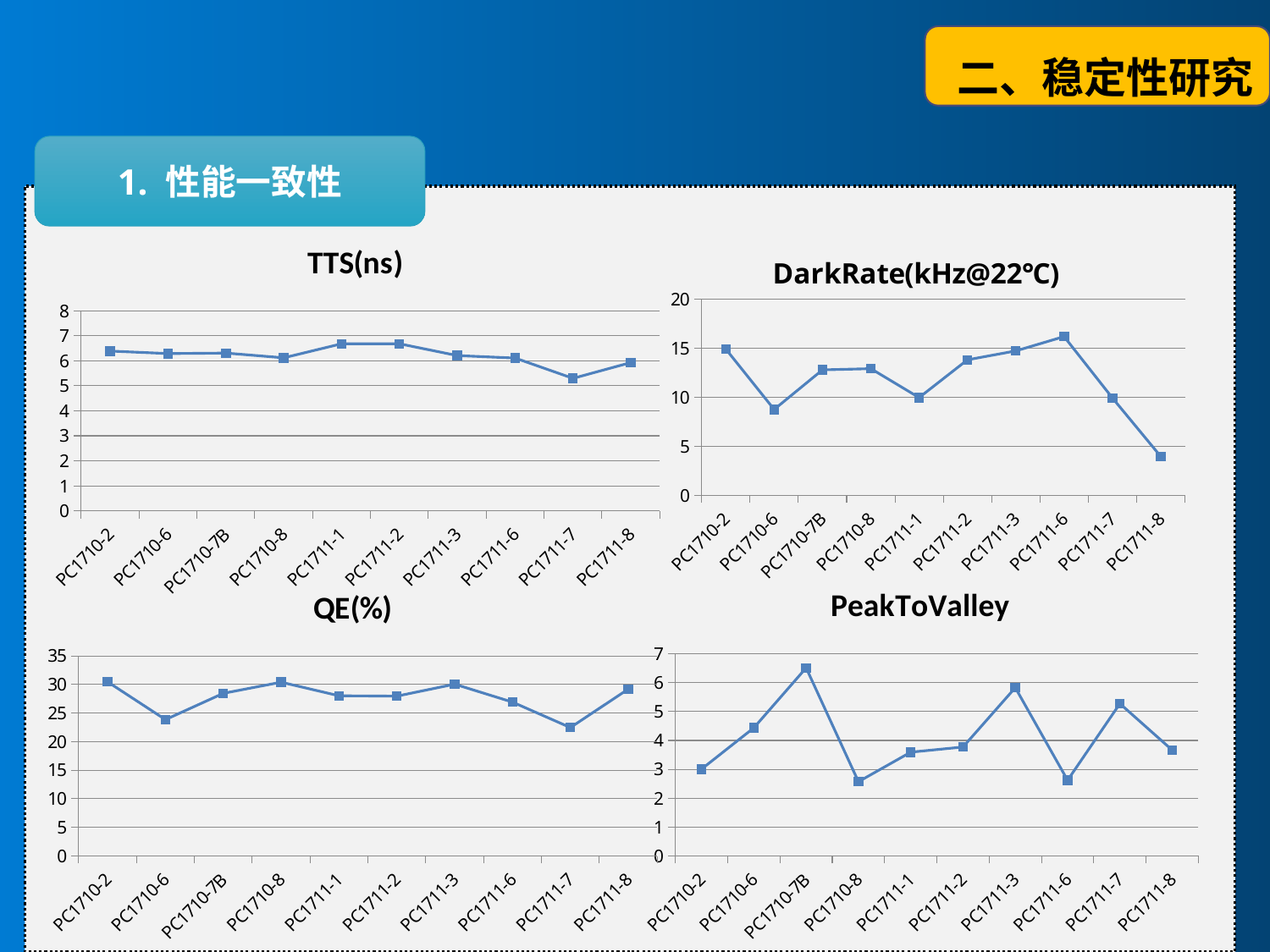
In the DarkRate(kHz@22℃) chart, which category has the lowest value? PC1711-8 In the TTS(ns) chart, which category has the lowest value? PC1711-7 What kind of chart is the TTS(ns) chart? line chart In the DarkRate(kHz@22℃) chart, which category has the highest value? PC1711-6 In the TTS(ns) chart, is the value for PC1711-7 greater or less than 6? less In the QE(%) chart, which category has the lowest value? PC1711-7 In the QE(%) chart, is the value for PC1710-6 greater or less than 25? less In the DarkRate(kHz@22℃) chart, which is larger, the value for PC1710-2 or the value for PC1710-6? PC1710-2 How many charts are shown on the slide? 4 In the DarkRate(kHz@22℃) chart, is the value for PC1710-6 greater or less than 10? less In the PeakToValley chart, which category has the highest value? PC1710-7B How many categories are plotted on the x axis of the DarkRate(kHz@22℃) chart? 10